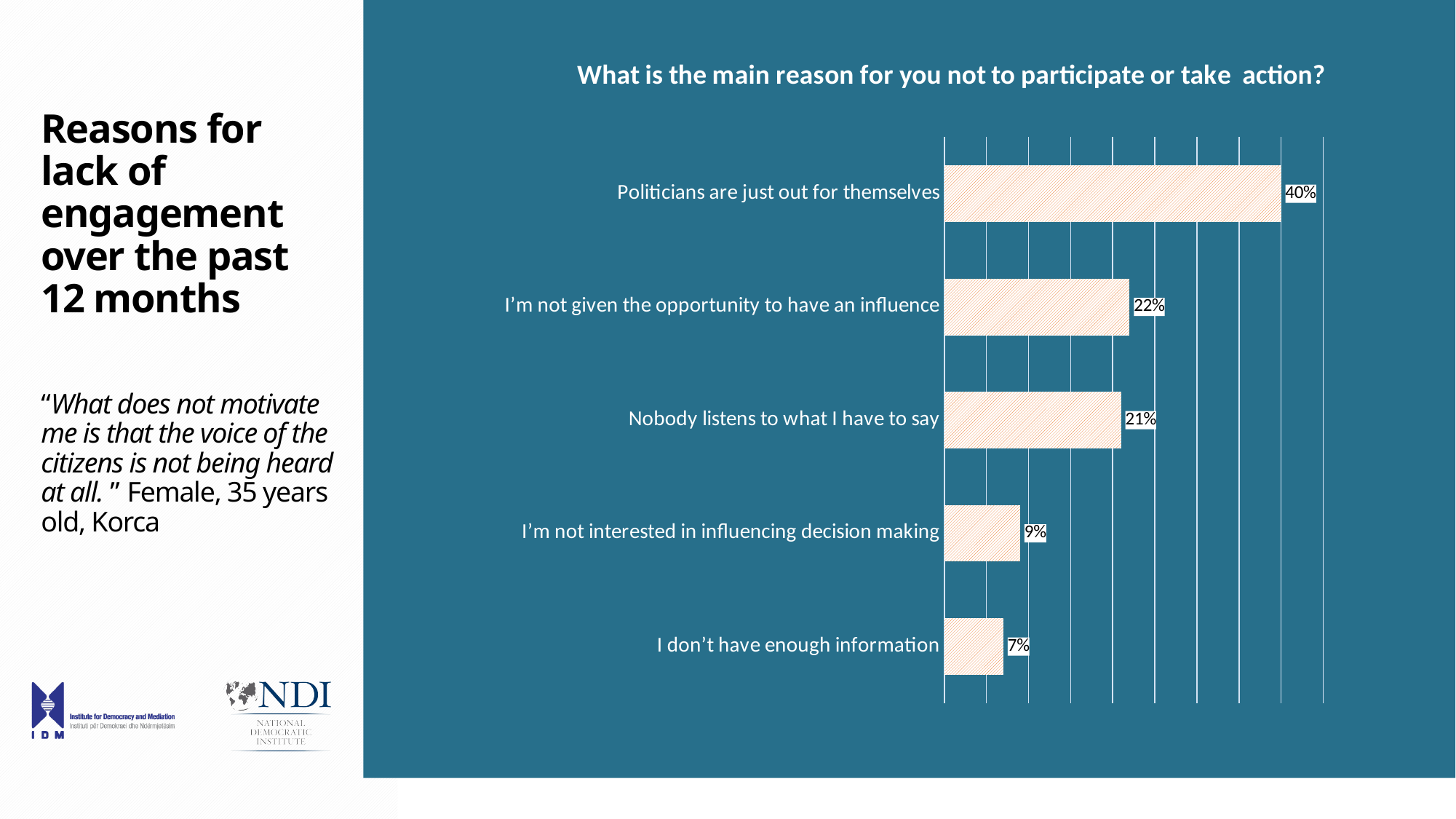
What percentage of respondents said "Politicians are just out for themselves"? 40% What is the title of the chart? What is the main reason for you not to participate or take action? What kind of chart is shown on the slide? Bar chart What is the value for "Nobody listens to what I have to say"? 21% How many reasons are shown in the chart? 5 Which reason has the highest value? Politicians are just out for themselves Which is larger: "Nobody listens to what I have to say" or "I'm not interested in influencing decision making"? Nobody listens to what I have to say Which reason has the lowest value? I don't have enough information What is the value for "I don't have enough information"? 7% What is the value for "I'm not given the opportunity to have an influence"? 22% What is the difference between "Politicians are just out for themselves" and "I'm not given the opportunity to have an influence"? 18% What is the difference between "I'm not interested in influencing decision making" and "I don't have enough information"? 2%